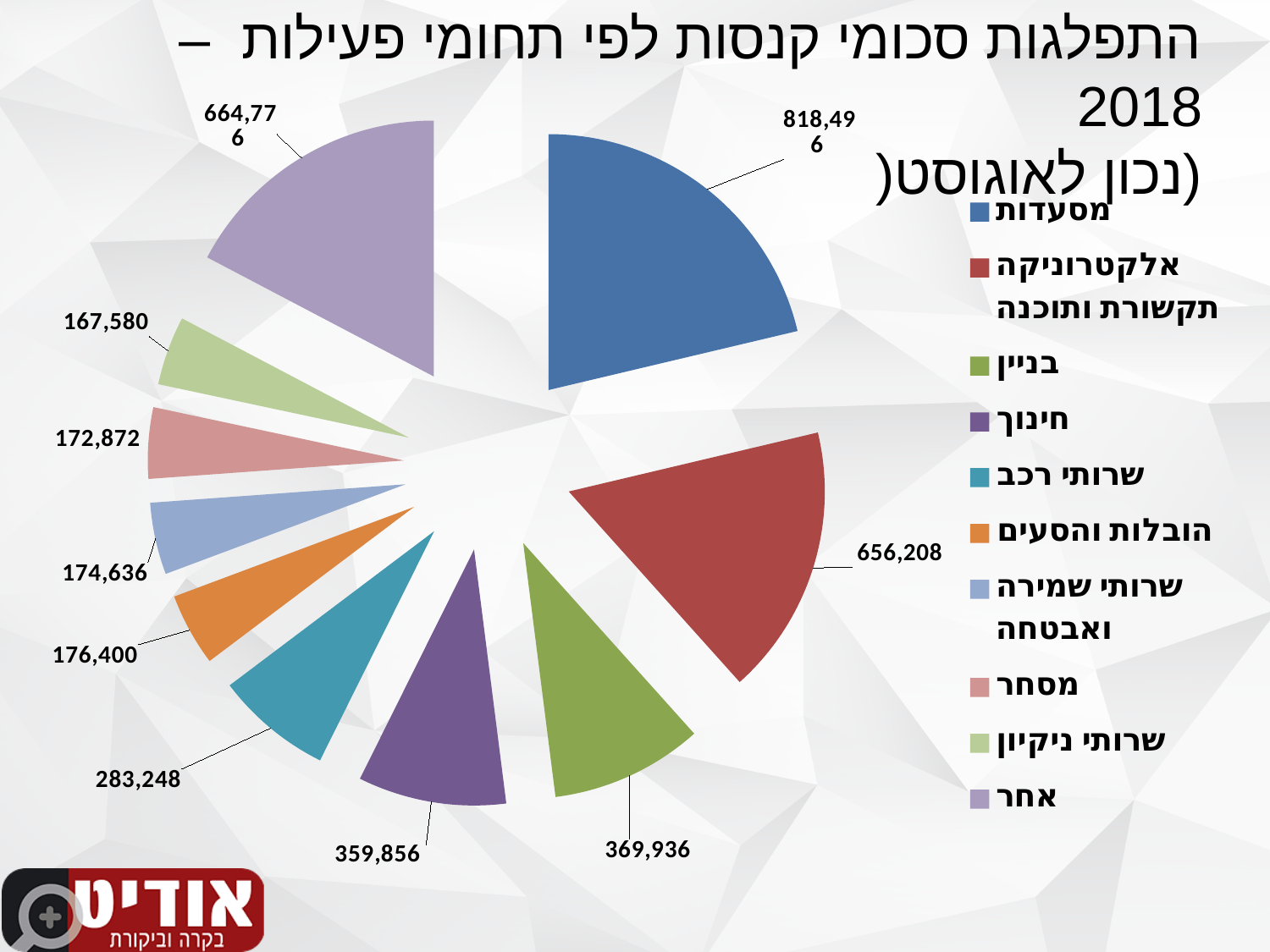
What is the value shown for אלקטרוניקה תקשורת ותוכנה? 656,208 What is the value shown for אחר? 664,776 What is the difference between the values for מסעדות and אחר? 153,720 Which category is shown in orange in the pie chart? הובלות והסעים What type of chart is shown on the slide? Pie chart What is the difference between the values for בניין and חינוך? 10,080 Which category has the smallest slice of the pie? שרותי ניקיון How many categories does the legend of the pie chart list? 10 Which category has the largest slice of the pie? מסעדות What is the value shown for מסעדות? 818,496 What is the value shown for שרותי רכב? 283,248 Which is larger, the value for אחר or the value for אלקטרוניקה תקשורת ותוכנה? אחר